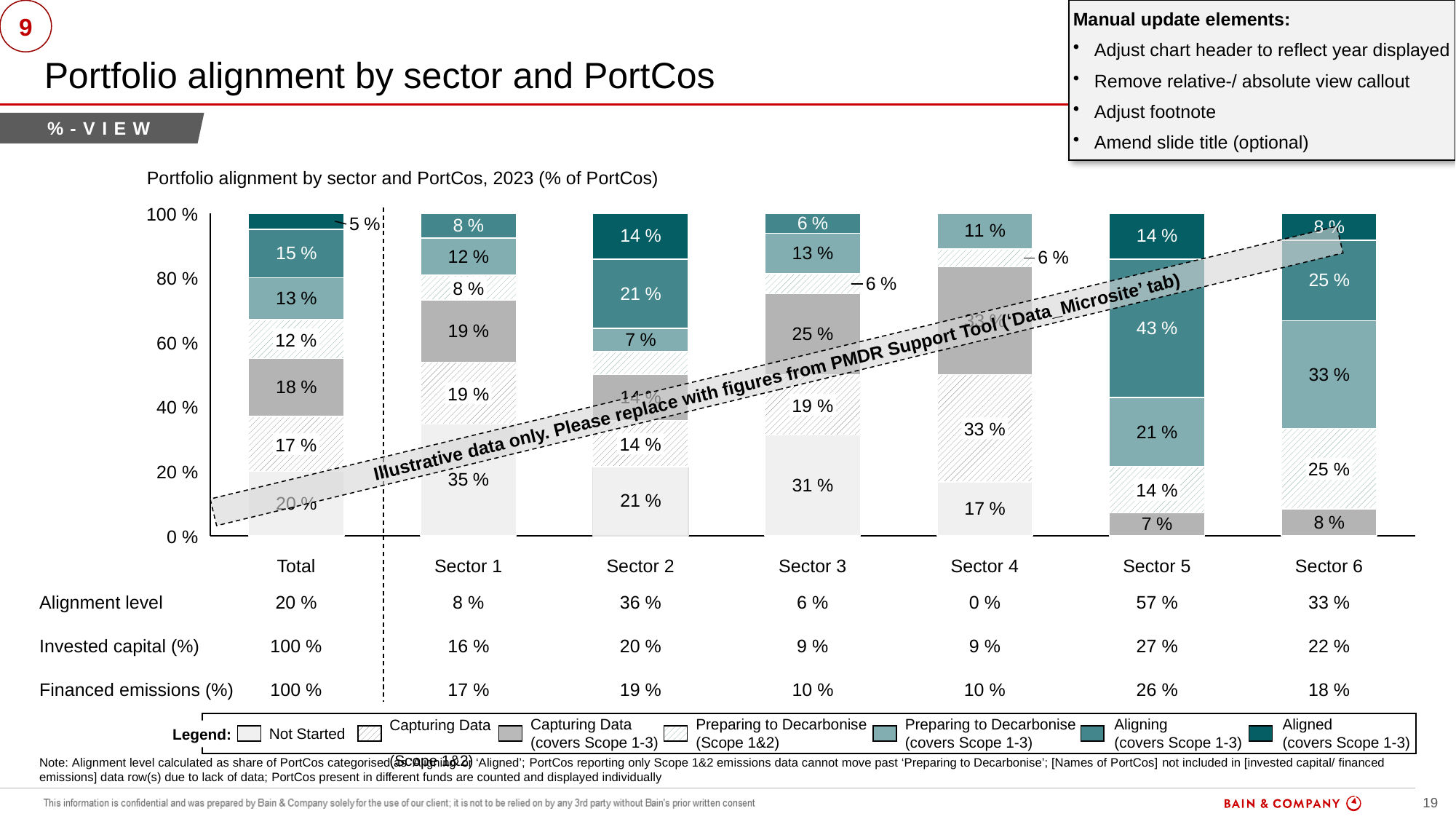
What type of chart is shown on the slide? Stacked bar chart Which has a larger 'Aligned (covers Scope 1-3)' share, Sector 2 or Sector 1? Sector 2 What is the 'Aligning (covers Scope 1-3)' share for Sector 5? 43 % What is the 'Not Started' share for Sector 1? 35 % How many series does the chart legend list? 7 What is the difference between the 'Aligning (covers Scope 1-3)' share for Sector 5 and for Sector 6? 18 percentage points What is the title of the chart? Portfolio alignment by sector and PortCos, 2023 (% of PortCos) How many categories (bars) are shown on the x axis of the chart? 7 What is the 'Capturing Data (covers Scope 1-3)' share for Sector 3? 25 % What is the 'Aligned (covers Scope 1-3)' share for Sector 2? 14 % Which sector has the largest 'Not Started' share? Sector 1 Which sector has the smallest 'Not Started' share? Sector 5